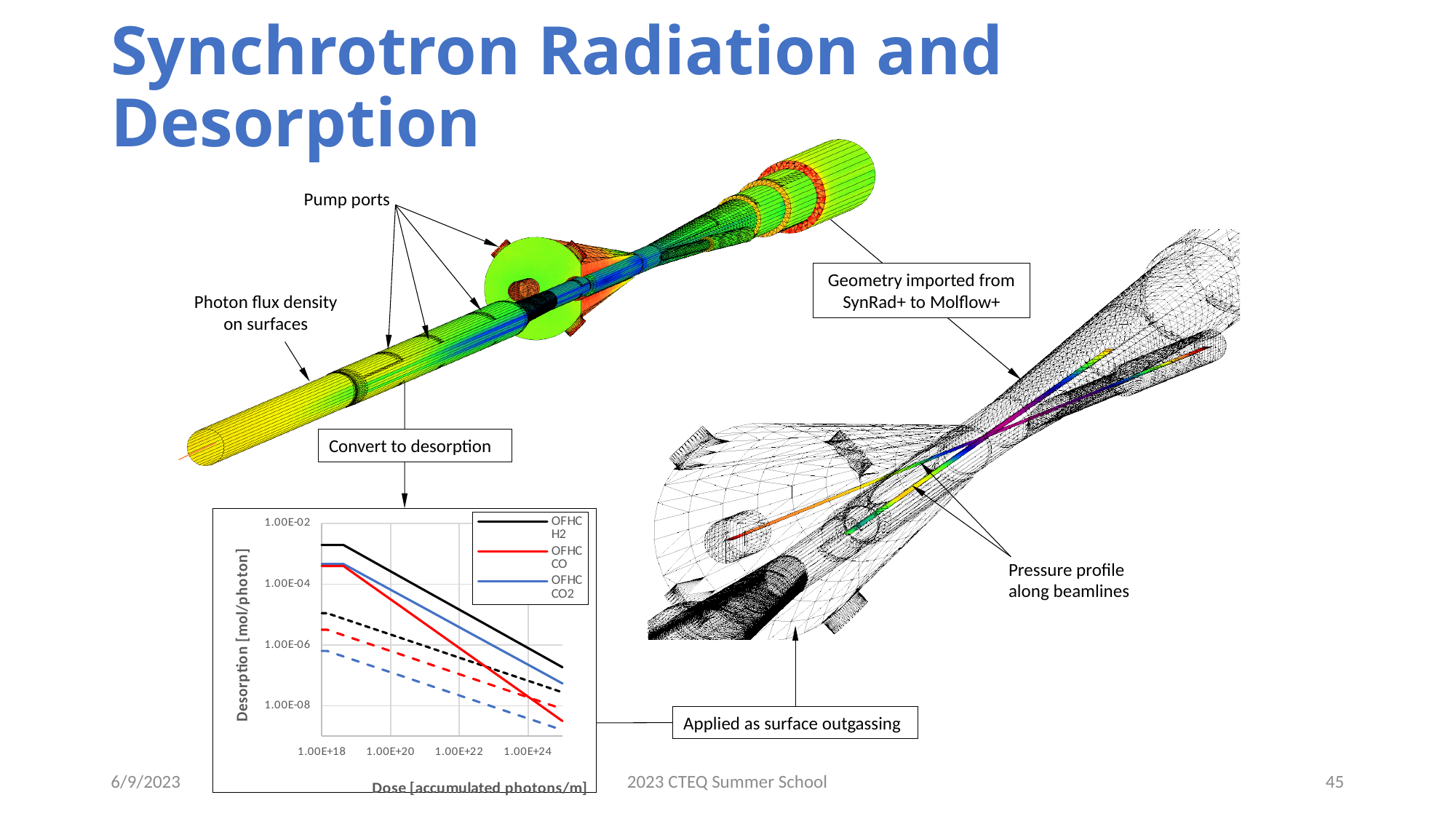
At a dose of 1.00E+18, is the desorption for OFHC H2 greater or less than 1.00E-04? greater At a dose of 1.00E+18, is the desorption for OFHC H2 larger or smaller than that for OFHC CO? larger Which series has the highest desorption at the right end of the chart? OFHC H2 How many tick labels are shown on the chart's x axis? 4 Which legend series is drawn in red? OFHC CO Do the desorption values rise or fall as the dose increases along the x axis? fall Which of the three legend series has the lowest desorption at the right end of the chart? OFHC CO What kind of chart is shown on the slide? line chart What is the label of the chart's y axis? Desorption [mol/photon] How many series does the chart legend list? 3 What is the label of the chart's x axis? Dose [accumulated photons/m]